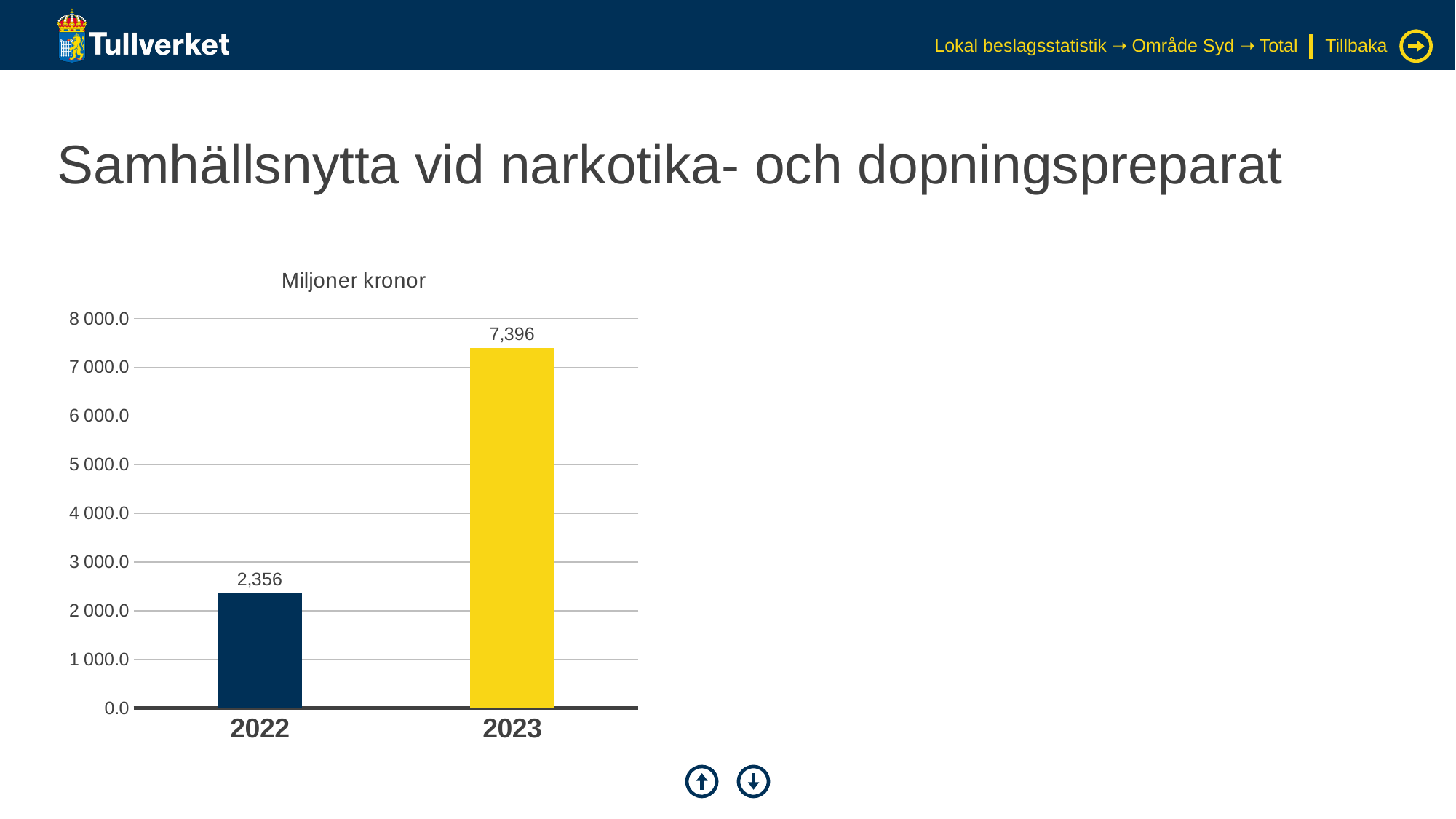
Which year has the lowest value? 2022 Which year has the highest value? 2023 What kind of chart is shown on the slide? bar chart What is the difference between the values for 2023 and 2022? 5,040 How many years are shown on the x axis? 2 What is the value for 2022? 2,356 Which is larger, the value for 2022 or the value for 2023? 2023 Do the values rise or fall from 2022 to 2023? rise What is the value for 2023? 7,396 Is the value for 2022 greater or less than 3 000.0? less What unit is shown above the chart? Miljoner kronor Is the value for 2023 greater or less than 7 000.0? greater